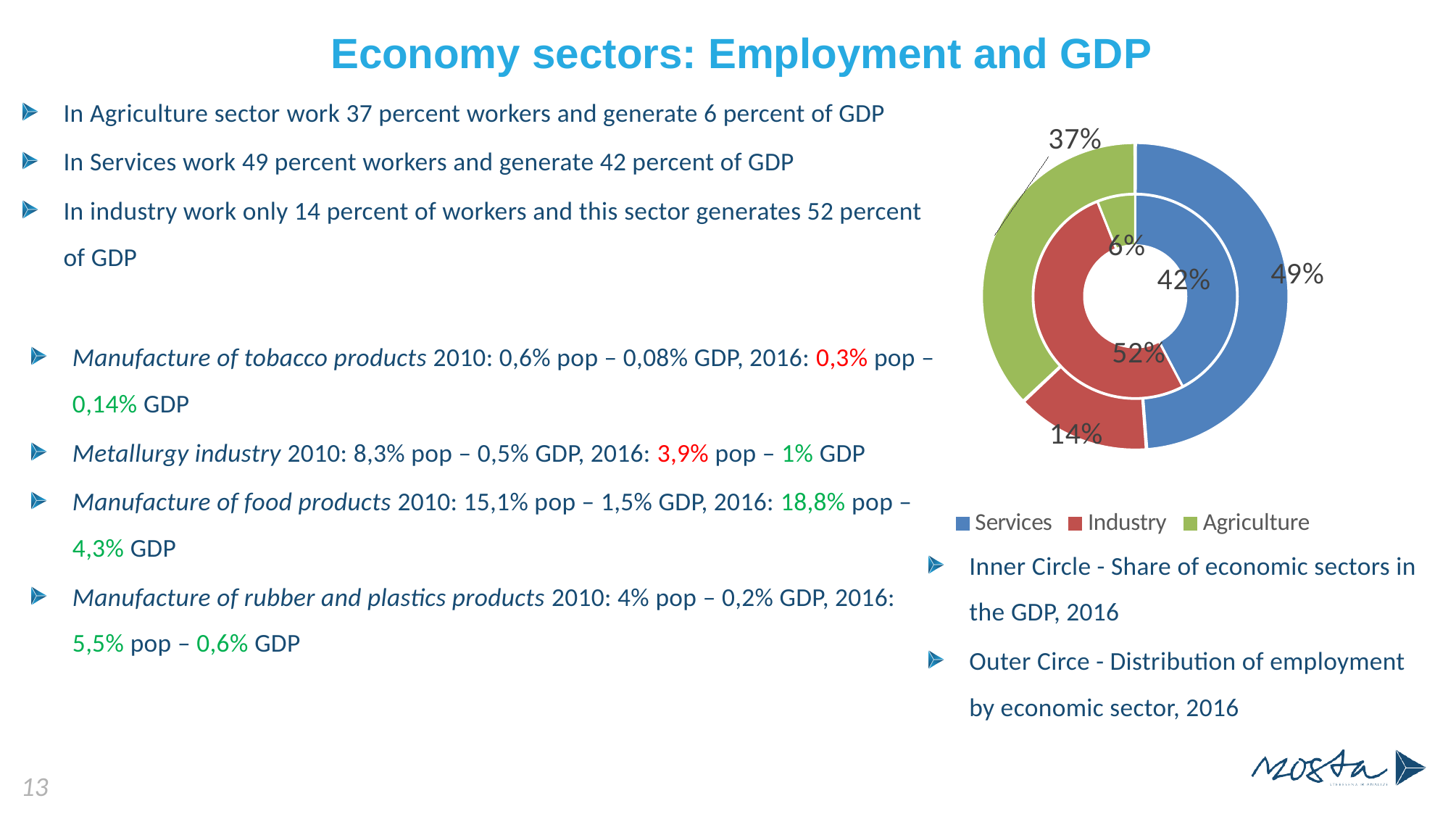
In the outer ring (distribution of employment, 2016), what is the value for Agriculture? 37% Which colour represents Agriculture in the chart? green In the inner ring (share of economic sectors in GDP, 2016), what is the value for Agriculture? 6% Which sector has the smallest share in the outer ring (employment, 2016)? Industry In the inner ring (share of economic sectors in GDP, 2016), what is the value for Industry? 52% In the outer ring (distribution of employment, 2016), what is the value for Services? 49% What kind of chart is shown on the slide? doughnut chart How many series does the chart legend list? 3 In the outer ring (distribution of employment, 2016), what is the value for Industry? 14% Which sector has the largest share in the inner ring (GDP, 2016)? Industry What is the difference between the Industry share of GDP (inner ring) and the Industry share of employment (outer ring)? 38% Which is larger: the Services share in the outer ring or the Services share in the inner ring? outer ring (49%)